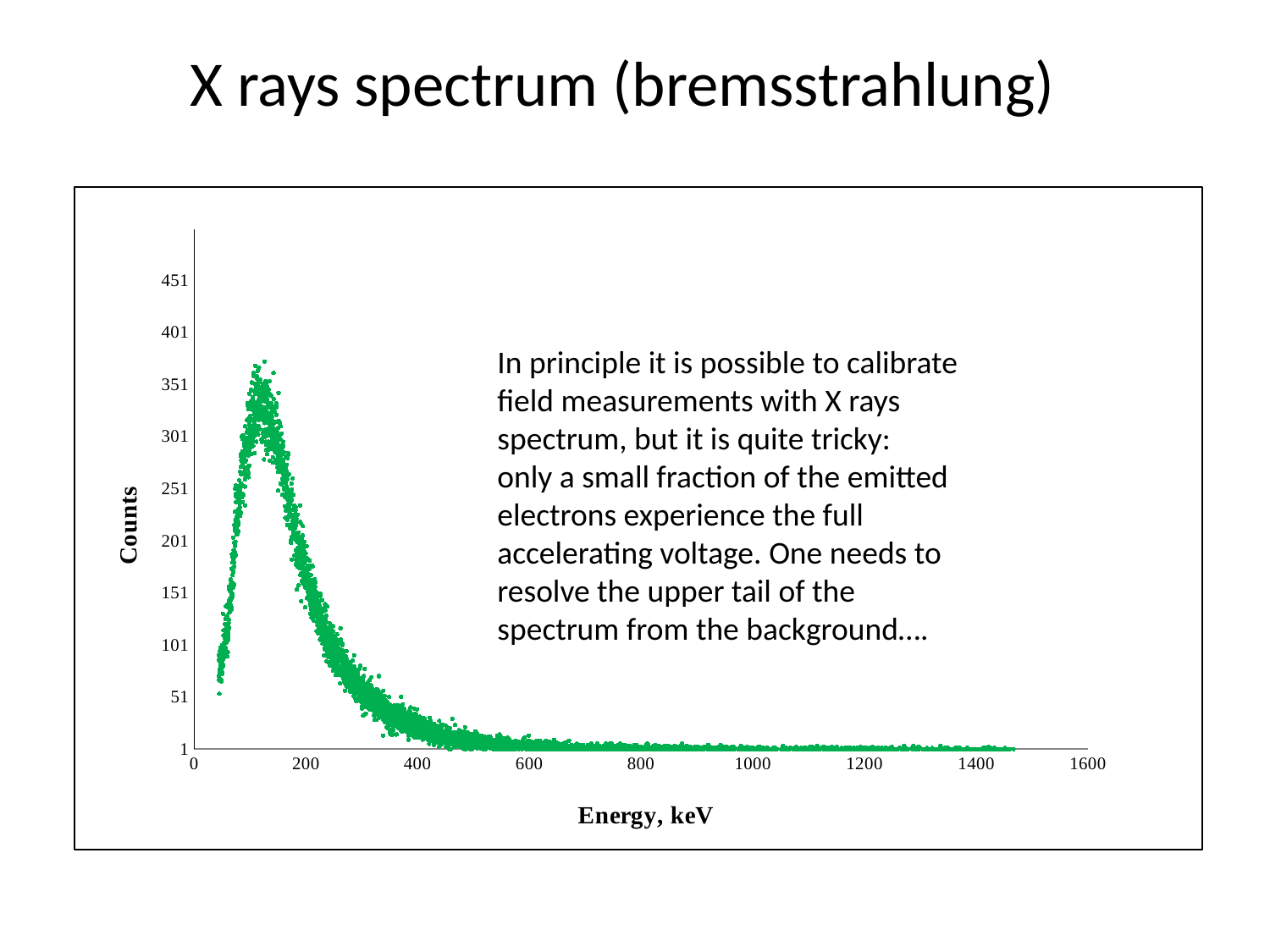
Is the value of Counts at an energy of 800 keV greater or less than 51? less What kind of chart is shown on the slide? scatter chart What is the highest value shown on the x axis of the chart? 1600 Are the Counts higher at an energy of about 100 keV or at an energy of about 1000 keV? about 100 keV What is the title of the slide containing the chart? X rays spectrum (bremsstrahlung) Do the Counts rise or fall as Energy increases from 200 keV to 600 keV? fall What is the label of the x axis of the chart? Energy, keV Is the value of Counts at an energy of 200 keV greater or less than 101? greater Is the value of Counts at an energy of 400 keV greater or less than 101? less